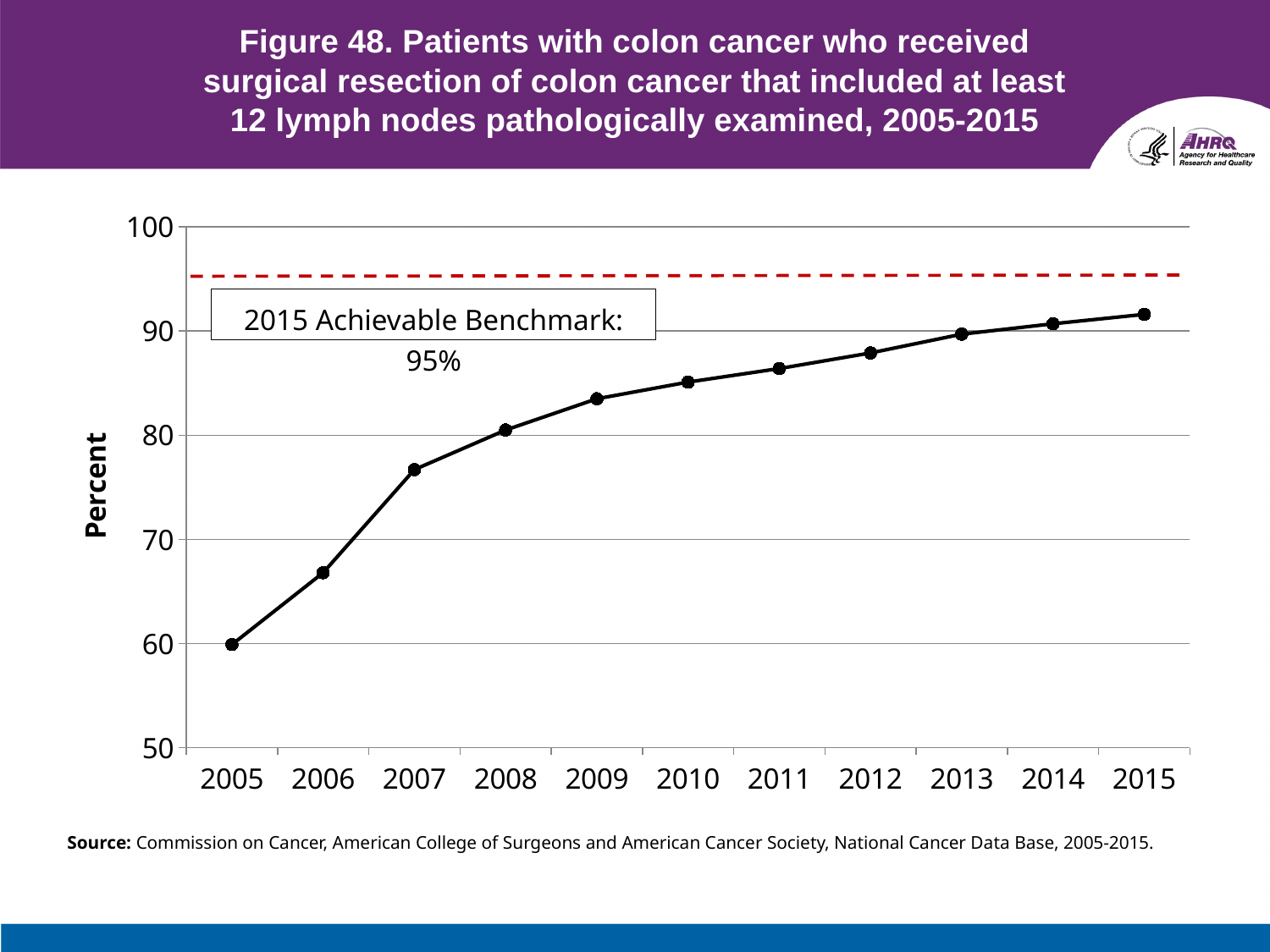
Which year has the highest plotted value? 2015 Which year has the lowest plotted value? 2005 Is the value for 2011 greater or less than 80? greater Is the value for 2007 greater or less than 70? greater Is the value for 2012 greater or less than 90? less What is the 2015 Achievable Benchmark shown by the dashed line? 95% What kind of chart is shown on the slide? line chart Which year has the larger value, 2006 or 2010? 2010 How many years are plotted along the x axis? 11 Do the plotted values rise or fall from 2005 to 2015? rise